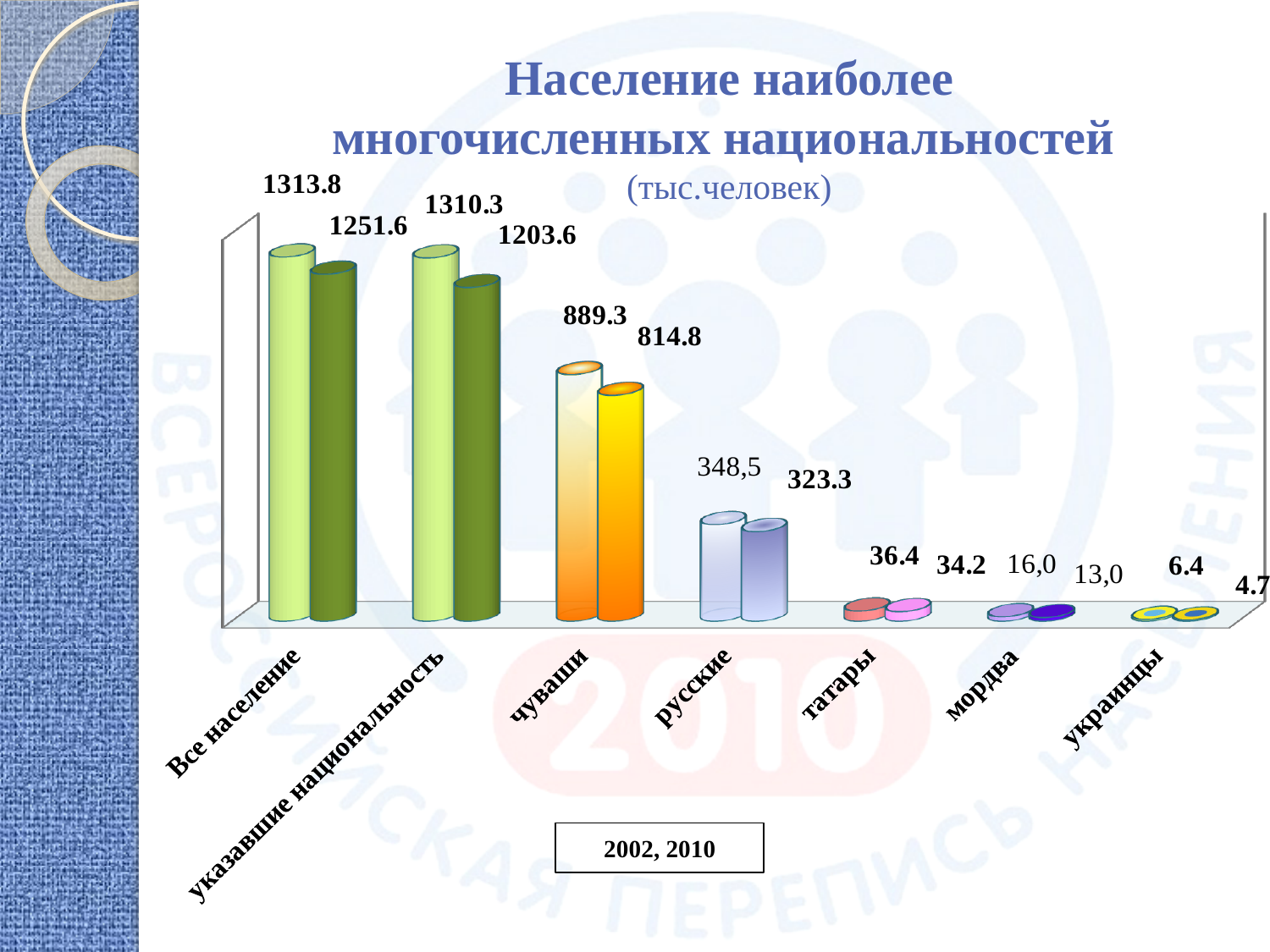
What are the two values shown for татары? 36.4 and 34.2 How many categories are shown along the x axis of the chart? 7 What are the two values shown for русские? 348,5 and 323.3 Which category has the highest values on the chart? Все население What is the difference between the two values shown for Все население (1313.8 and 1251.6)? 62.2 Which two years does the chart compare, according to the box below the chart? 2002, 2010 What is the higher of the two values shown for чуваши? 889.3 What are the two values shown for украинцы? 6.4 and 4.7 What kind of chart is shown on the slide? bar chart Which category has larger values, мордва or татары? татары What is the lower of the two values shown for чуваши? 814.8 Which category has the lowest values on the chart? украинцы